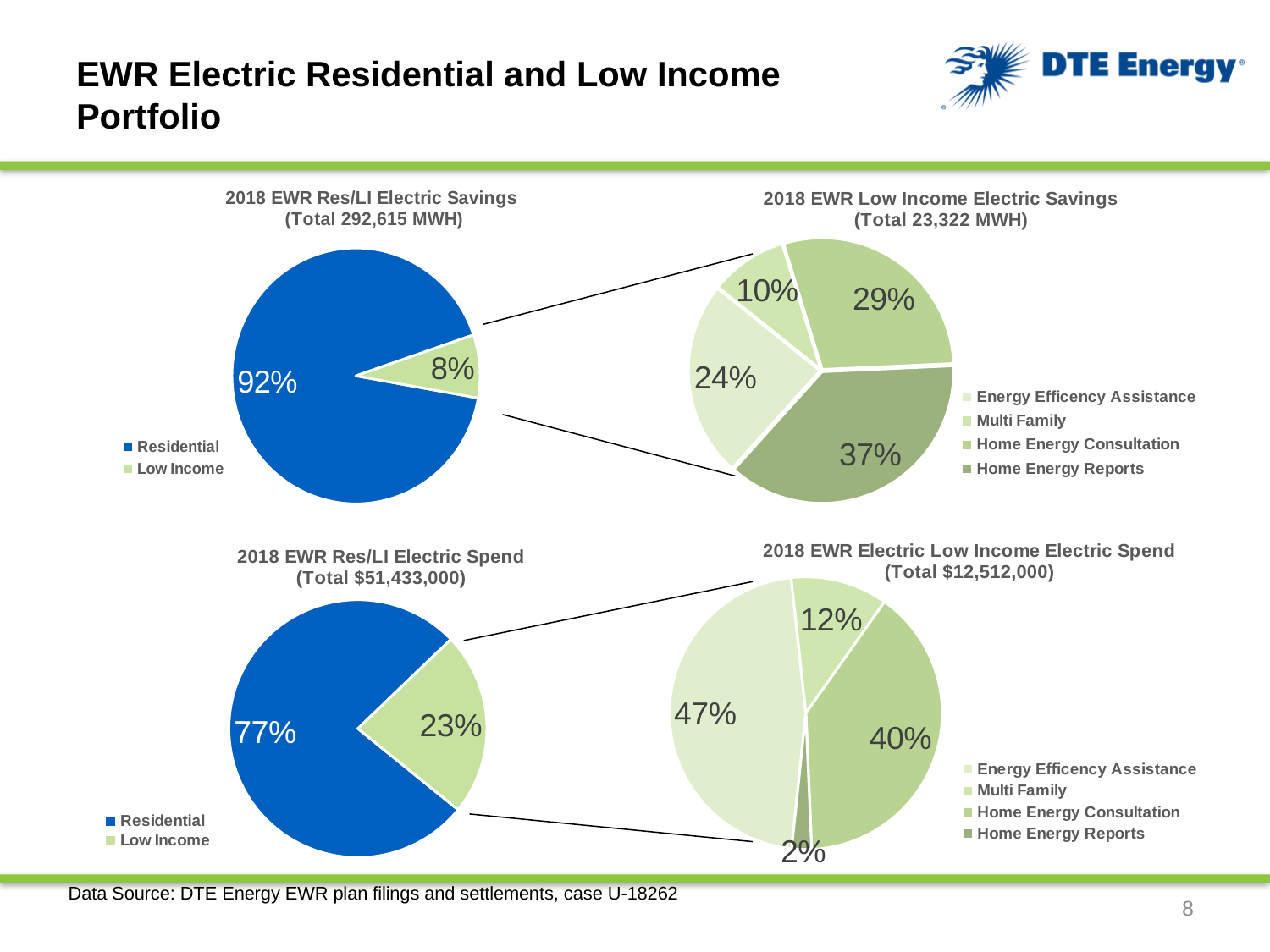
In the 2018 EWR Electric Low Income Electric Spend chart, what share is Home Energy Reports? 2% In the 2018 EWR Low Income Electric Savings chart, which category has the largest slice? Home Energy Reports In the 2018 EWR Res/LI Electric Savings chart, what share of savings is Low Income? 8% In the 2018 EWR Electric Low Income Electric Spend chart, which is larger: Home Energy Consultation or Multi Family? Home Energy Consultation In the 2018 EWR Low Income Electric Savings chart, what share is Home Energy Reports? 37% In the 2018 EWR Electric Low Income Electric Spend chart, which category has the largest slice? Energy Efficency Assistance In the 2018 EWR Res/LI Electric Spend chart, what is the difference between the Residential and Low Income shares? 54% What type of chart is the 2018 EWR Res/LI Electric Spend chart? Pie chart How many categories does the legend of the 2018 EWR Low Income Electric Savings chart list? 4 In the 2018 EWR Low Income Electric Savings chart, which category has the smallest slice? Multi Family